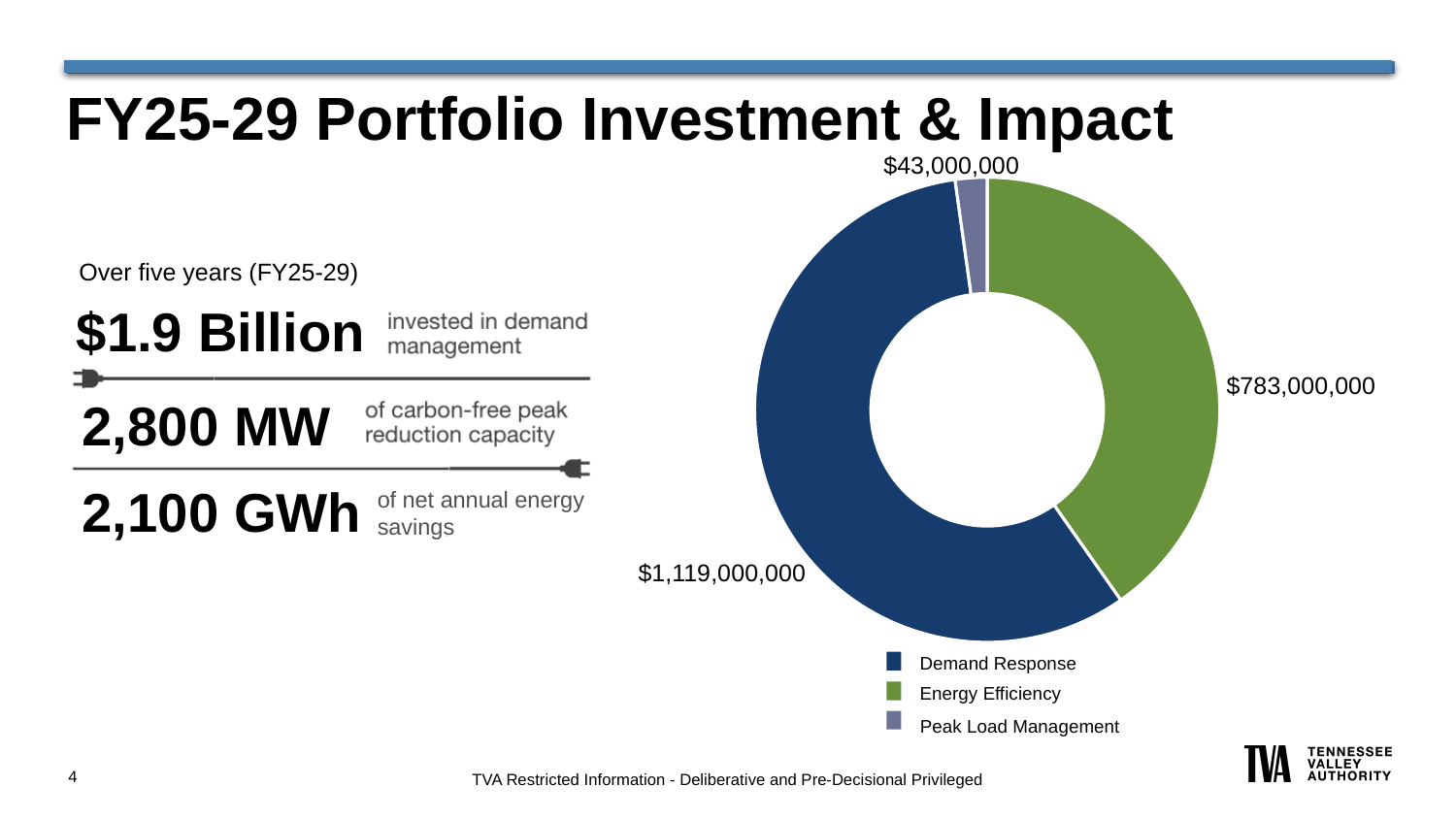
Which category has the smallest slice of the pie? Peak Load Management How many categories does the pie chart show? 3 What is the value for Demand Response? $1,119,000,000 What type of chart is shown on the slide? Pie (donut) chart Which is larger, Energy Efficiency or Peak Load Management? Energy Efficiency What is the value for Peak Load Management? $43,000,000 What is the difference between the Demand Response and Energy Efficiency values? $336,000,000 Which category has the largest slice of the pie? Demand Response What is the value for Energy Efficiency? $783,000,000 What is the difference between the Energy Efficiency and Peak Load Management values? $740,000,000 What is the total of all three slices in the pie chart? $1,945,000,000 What colour is the Energy Efficiency slice? Green